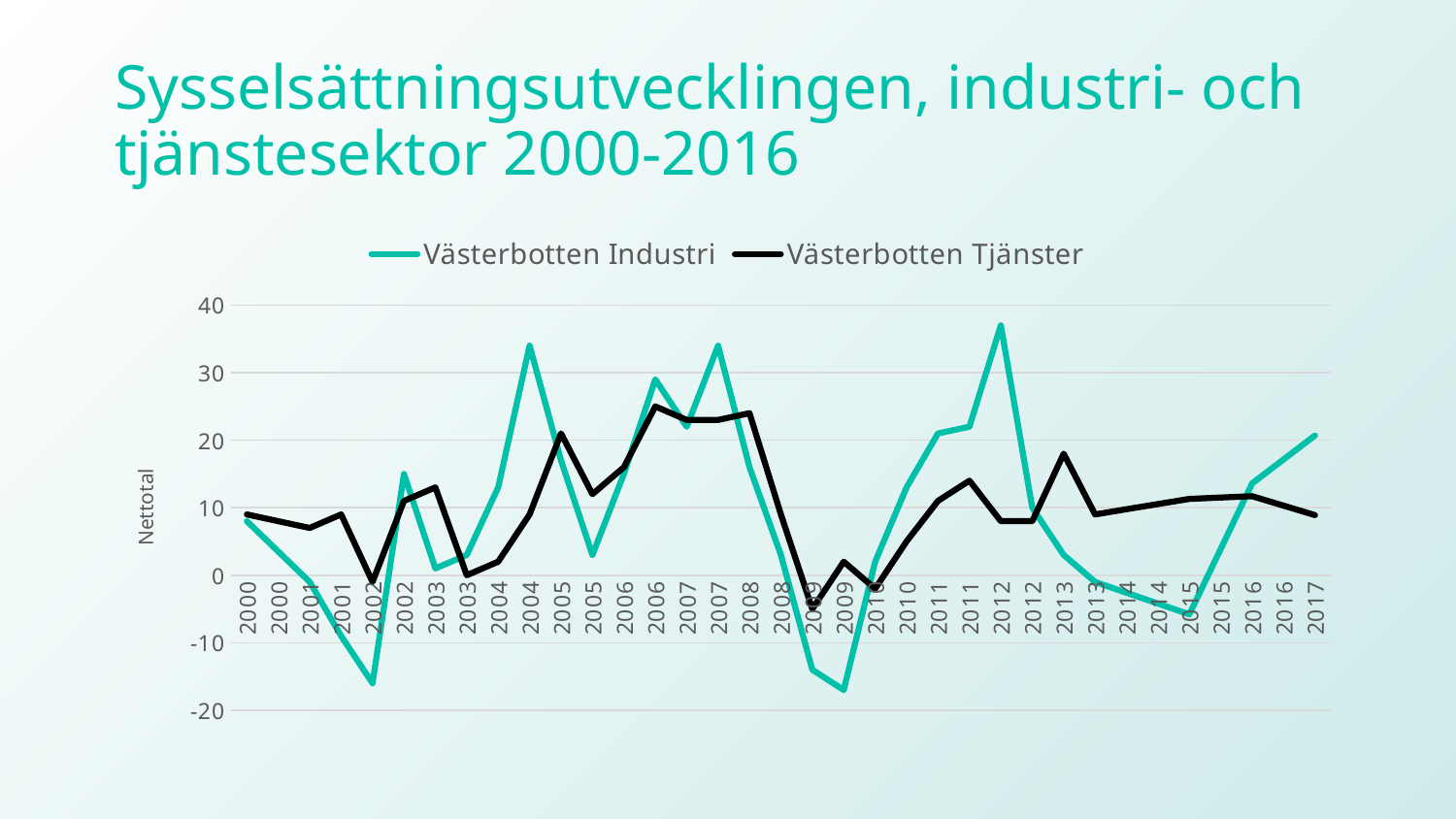
At the first 2012 point, which series has the larger value, Västerbotten Industri or Västerbotten Tjänster? Västerbotten Industri Does the Västerbotten Industri line rise or fall from the second 2014 point to 2017? rise What are the two series named in the legend? Västerbotten Industri and Västerbotten Tjänster What kind of chart is shown on the slide? Line chart What is the label on the vertical axis? Nettotal At the first 2015 point, which series has the larger value, Västerbotten Industri or Västerbotten Tjänster? Västerbotten Tjänster Is the lowest value of Västerbotten Industri in 2009 greater or less than -10? less Which series reaches the highest value on the chart? Västerbotten Industri How many series does the legend list? 2 In which year does Västerbotten Industri reach its highest value? 2012 Is the value of Västerbotten Tjänster at its 2013 peak greater or less than 10? greater Is the peak value of Västerbotten Industri in 2012 greater or less than 30? greater